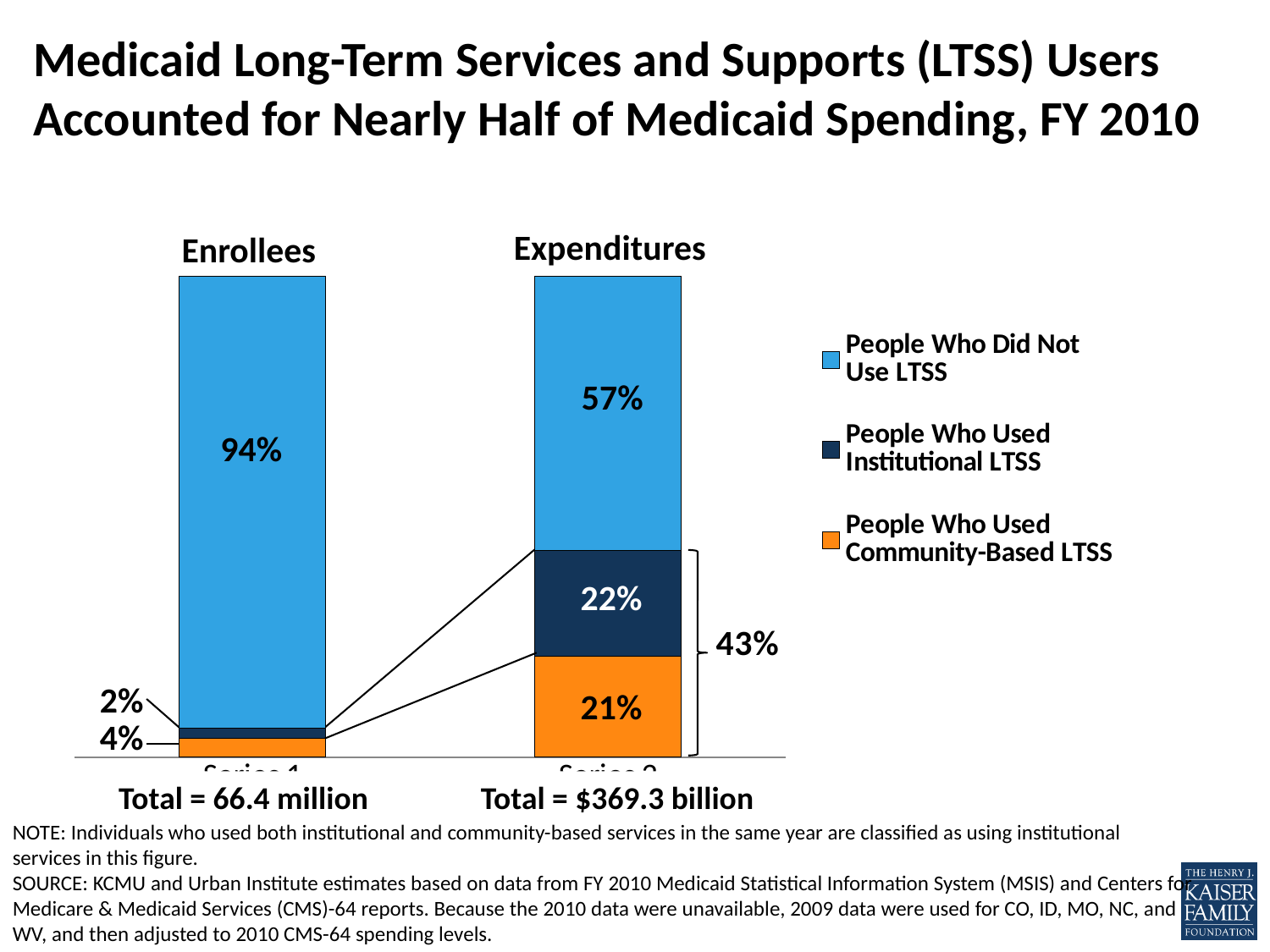
What is the total number of enrollees shown under the Enrollees bar? 66.4 million What is the total expenditure amount shown under the Expenditures bar? $369.3 billion What share of Medicaid enrollees did not use LTSS? 94% Which is larger: the share of expenditures for people who used institutional LTSS or the share for people who used community-based LTSS? Institutional LTSS What share of enrollees used community-based LTSS? 4% How many series does the legend list? 3 What kind of chart is shown on the slide? Stacked bar chart What share of enrollees used institutional LTSS? 2% What share of Medicaid expenditures went to people who used institutional LTSS? 22% What share of Medicaid expenditures went to people who used community-based LTSS? 21% What is the combined share of expenditures for people who used any LTSS (institutional or community-based), as labeled by the bracket? 43% What is the difference between the share of enrollees who did not use LTSS and the share of expenditures for people who did not use LTSS? 37 percentage points